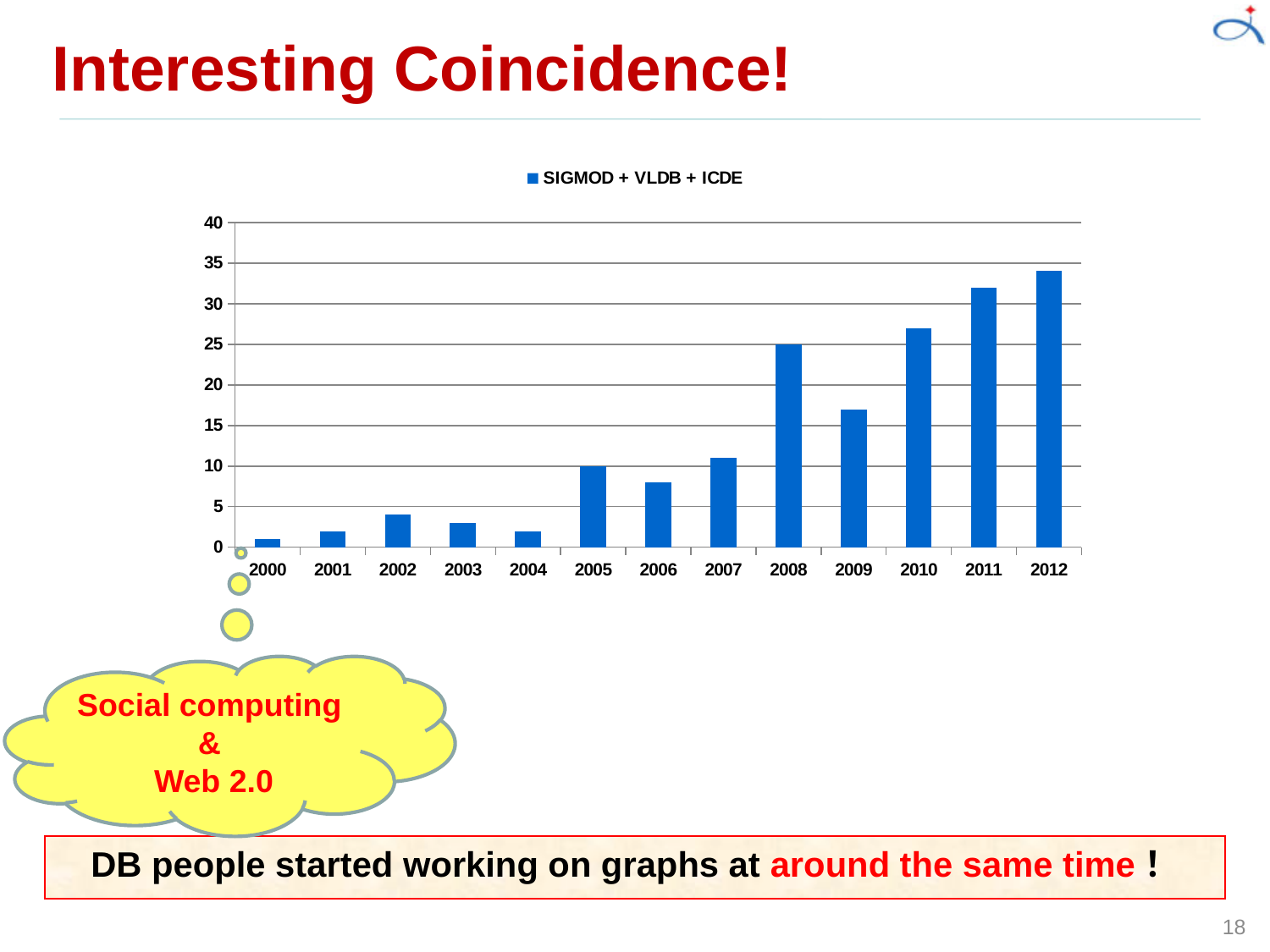
Is the value for 2006 greater or less than 10? less Is the value for 2012 greater or less than 30? greater What is the name of the series shown in the legend? SIGMOD + VLDB + ICDE What kind of chart is shown on the slide? bar chart How many years are shown on the x axis? 13 What is the value for 2005? 10 How many series does the legend list? 1 Which year has the highest value? 2012 Do the values generally rise or fall from 2000 to 2012? rise What is the value for 2008? 25 Which year has the lowest value? 2000 Which is larger, the value for 2011 or the value for 2009? 2011